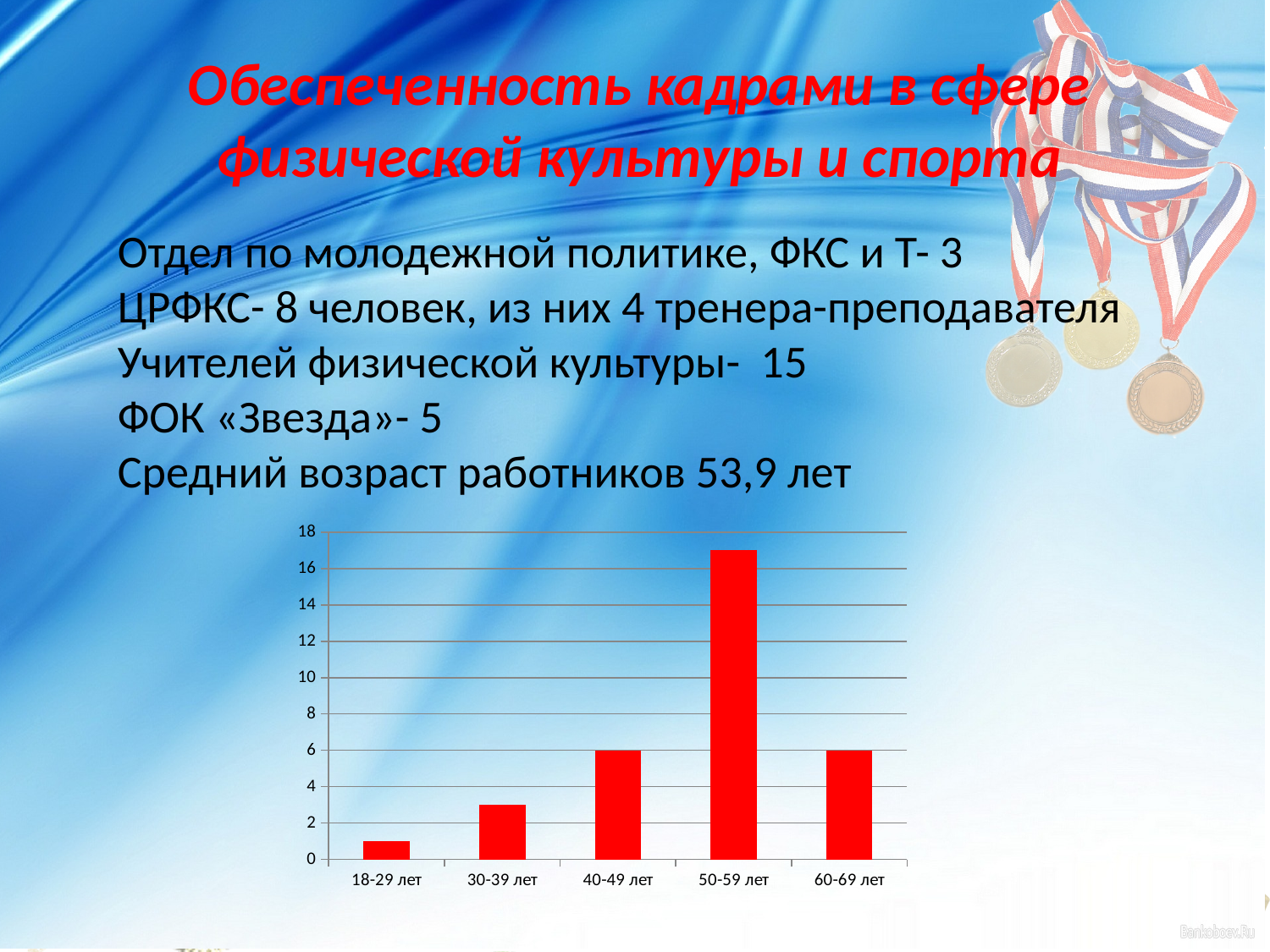
What is the difference between the values for 40-49 лет and 60-69 лет? 0 How many age categories are shown on the x axis of the chart? 5 Which age category has the highest bar in the chart? 50-59 лет What colour are the bars in the chart? red Is the value for 30-39 лет greater or less than 4? less What is the value for the 40-49 лет category? 6 What is the value for the 60-69 лет category? 6 What kind of chart is shown on the slide? bar chart Which age category has the lowest bar in the chart? 18-29 лет Is the value for 50-59 лет greater or less than 16? greater Is the value for 18-29 лет greater or less than 2? less Which is larger, the value for 50-59 лет or the value for 40-49 лет? 50-59 лет